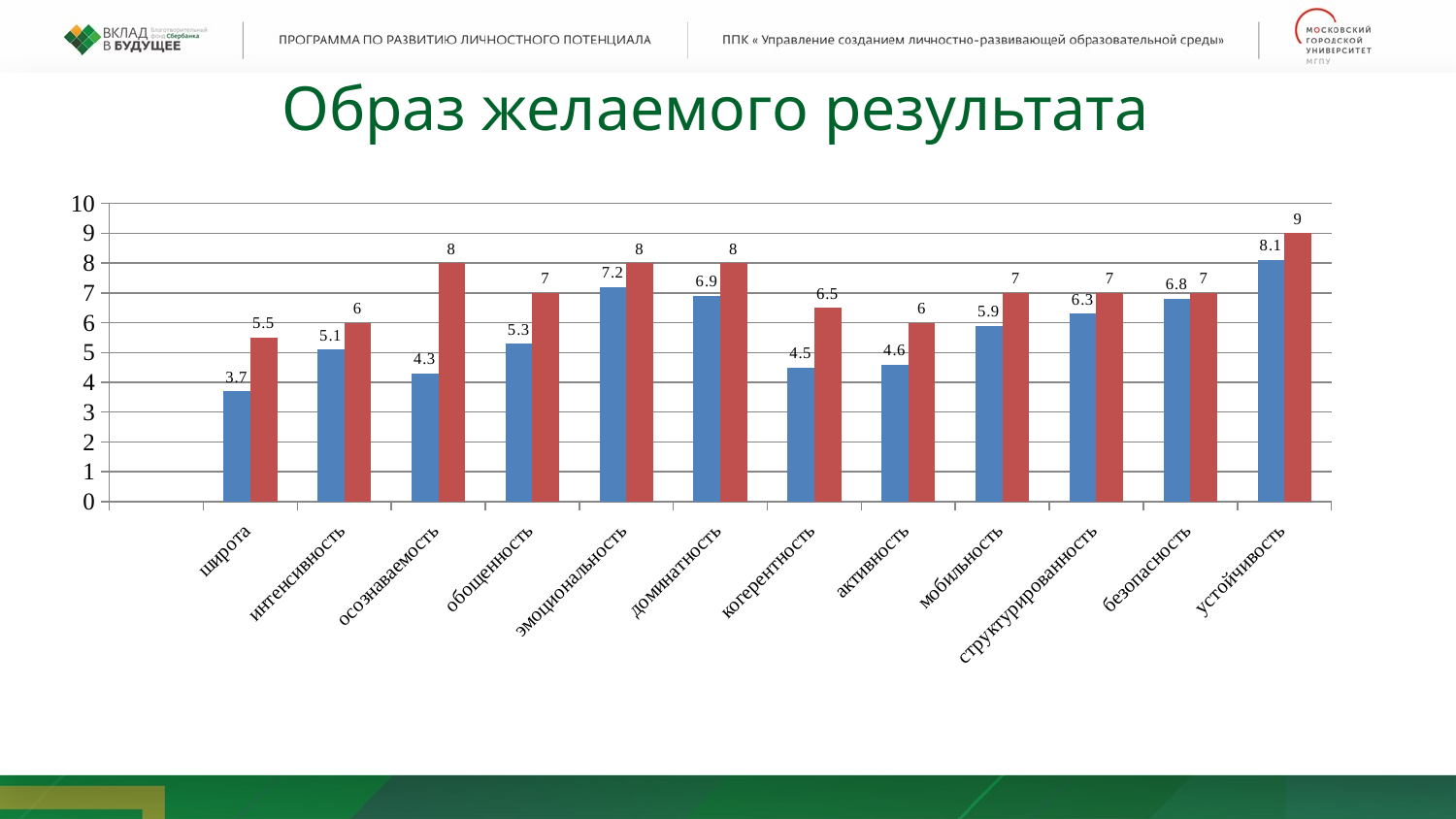
What is the difference between the red and blue bars for осознаваемость? 3.7 What is the value of the red bar for когерентность? 6.5 What kind of chart is shown on the slide? bar chart What is the value of the blue bar for эмоциональность? 7.2 What is the value of the red bar for устойчивость? 9 Which category has the highest blue bar? устойчивость How many categories are shown on the x axis? 12 Which category has the lowest red bar? широта Which category has the lowest blue bar? широта Which is larger for доминантность: the blue bar or the red bar? the red bar What is the title of the slide above the chart? Образ желаемого результата What is the value of the blue bar for широта? 3.7